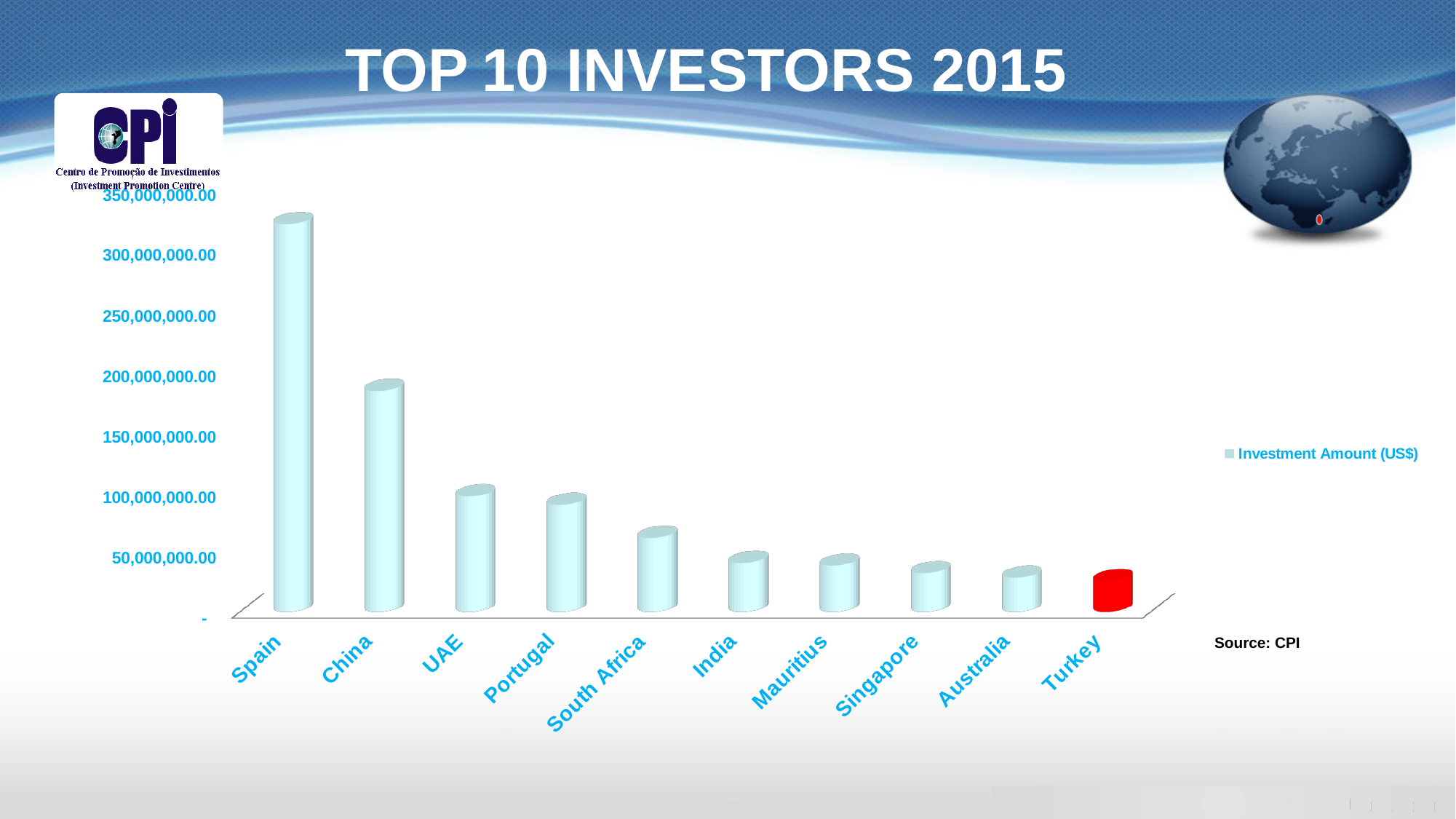
Is the investment amount for South Africa greater or less than 50,000,000.00? greater Do the investment amounts rise or fall moving from left to right along the x axis? fall Is the investment amount for China greater or less than 200,000,000.00? less Which country has the highest investment amount in the chart? Spain Which country has the lowest investment amount in the chart? Turkey Is the investment amount for Turkey greater or less than 50,000,000.00? less What is the series name shown in the chart legend? Investment Amount (US$) What kind of chart is shown on the slide? bar chart How many countries are shown on the x axis of the chart? 10 How many series does the chart legend list? 1 Which has a larger investment amount, China or UAE? China